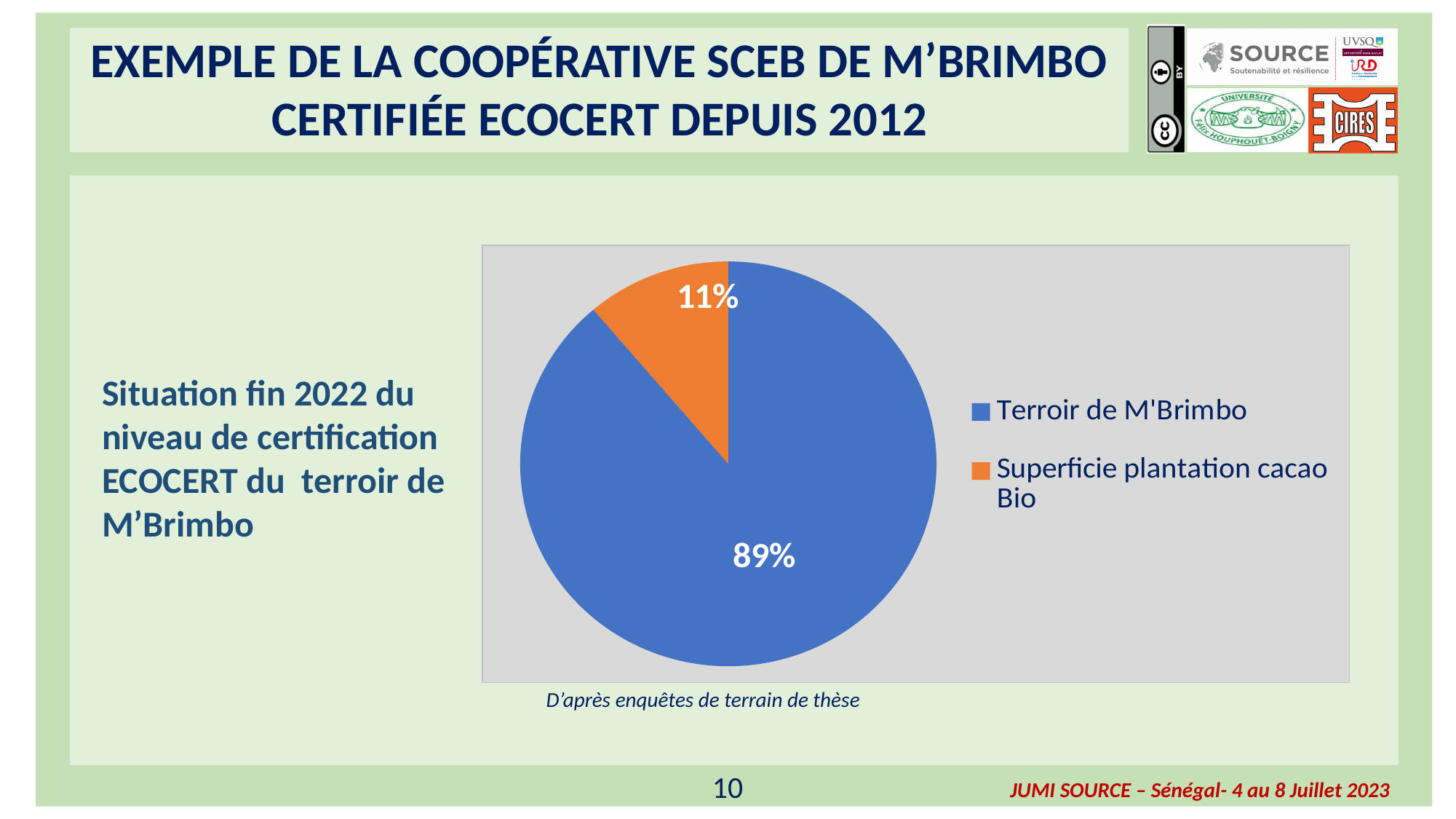
What is the difference in percentage points between the Terroir de M'Brimbo slice and the Superficie plantation cacao Bio slice? 78 What source is cited below the chart? D'après enquêtes de terrain de thèse How many slices does the pie chart have? 2 What share of the pie does Terroir de M'Brimbo represent? 89% What share of the pie does Superficie plantation cacao Bio represent? 11% What colour is the Superficie plantation cacao Bio slice? orange Which is larger: the Terroir de M'Brimbo slice or the Superficie plantation cacao Bio slice? Terroir de M'Brimbo Which slice of the pie is the smallest? Superficie plantation cacao Bio How many entries does the legend list? 2 Which slice of the pie is the largest? Terroir de M'Brimbo What kind of chart is shown on the slide? pie chart